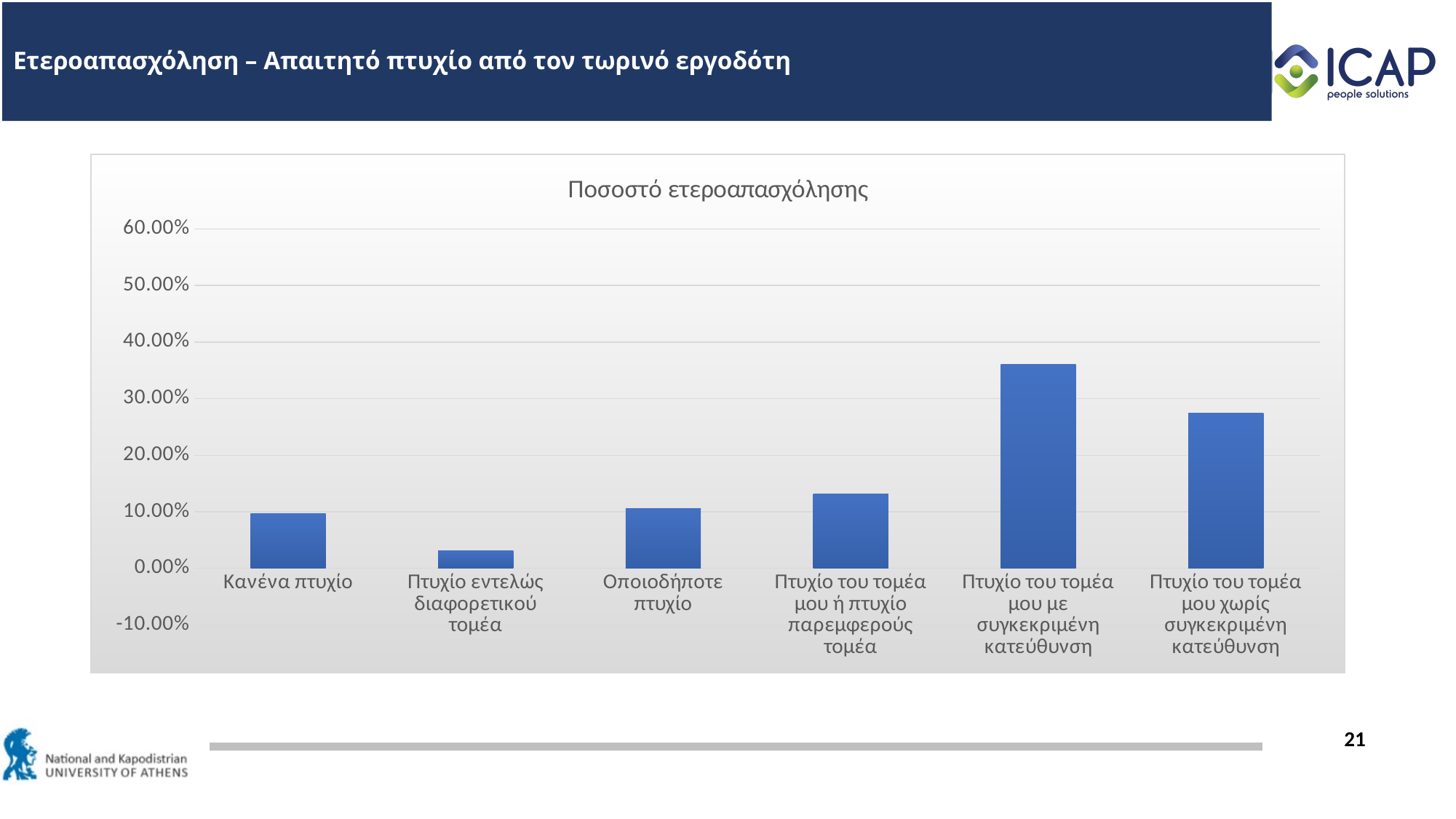
What is the title of the chart? Ποσοστό ετεροαπασχόλησης Is the value for 'Πτυχίο του τομέα μου χωρίς συγκεκριμένη κατεύθυνση' greater or less than 20.00%? greater Is the value for 'Πτυχίο εντελώς διαφορετικού τομέα' greater or less than 10.00%? less Which category has the highest value in the chart? Πτυχίο του τομέα μου με συγκεκριμένη κατεύθυνση Which category has the lowest value in the chart? Πτυχίο εντελώς διαφορετικού τομέα Is the value for 'Πτυχίο του τομέα μου ή πτυχίο παρεμφερούς τομέα' greater or less than 20.00%? less How many categories are shown on the x axis of the chart? 6 Which is larger: the value for 'Πτυχίο του τομέα μου με συγκεκριμένη κατεύθυνση' or 'Πτυχίο του τομέα μου χωρίς συγκεκριμένη κατεύθυνση'? Πτυχίο του τομέα μου με συγκεκριμένη κατεύθυνση What kind of chart is shown on the slide? bar chart